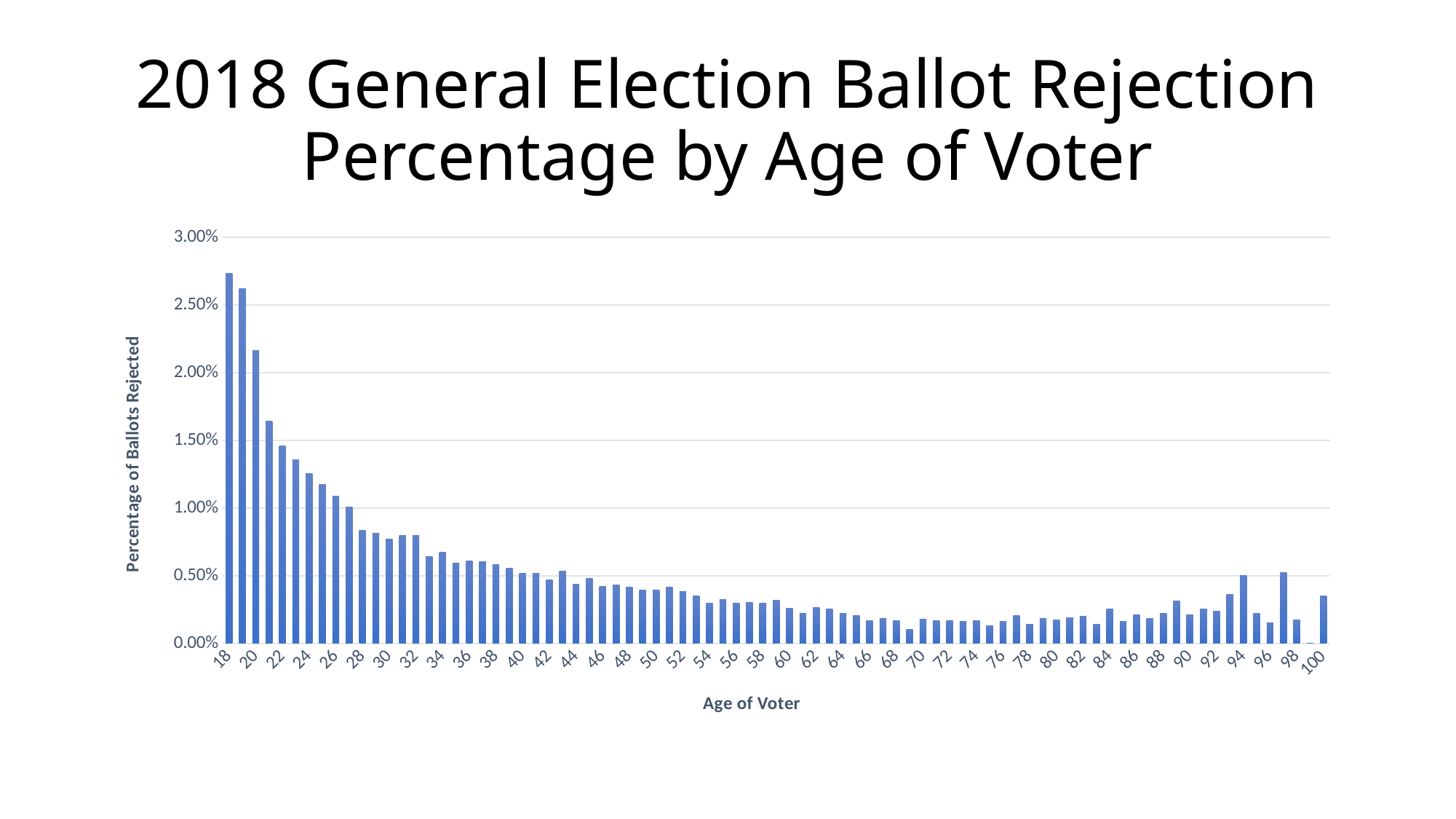
Do the percentages of ballots rejected generally rise or fall as the age of voter increases from 18 to 40? fall Which age of voter has the highest percentage of ballots rejected? 18 Is the percentage of ballots rejected for voters aged 24 greater or less than 1.00%? greater Which has a higher percentage of ballots rejected, voters aged 50 or voters aged 26? 26 What kind of chart is shown on the slide? bar chart Is the percentage of ballots rejected for voters aged 22 greater or less than 1.50%? less What is the title of the chart's horizontal axis? Age of Voter Is the percentage of ballots rejected for voters aged 70 greater or less than 0.50%? less What is the title of the chart's vertical axis? Percentage of Ballots Rejected Which has a higher percentage of ballots rejected, voters aged 18 or voters aged 22? 18